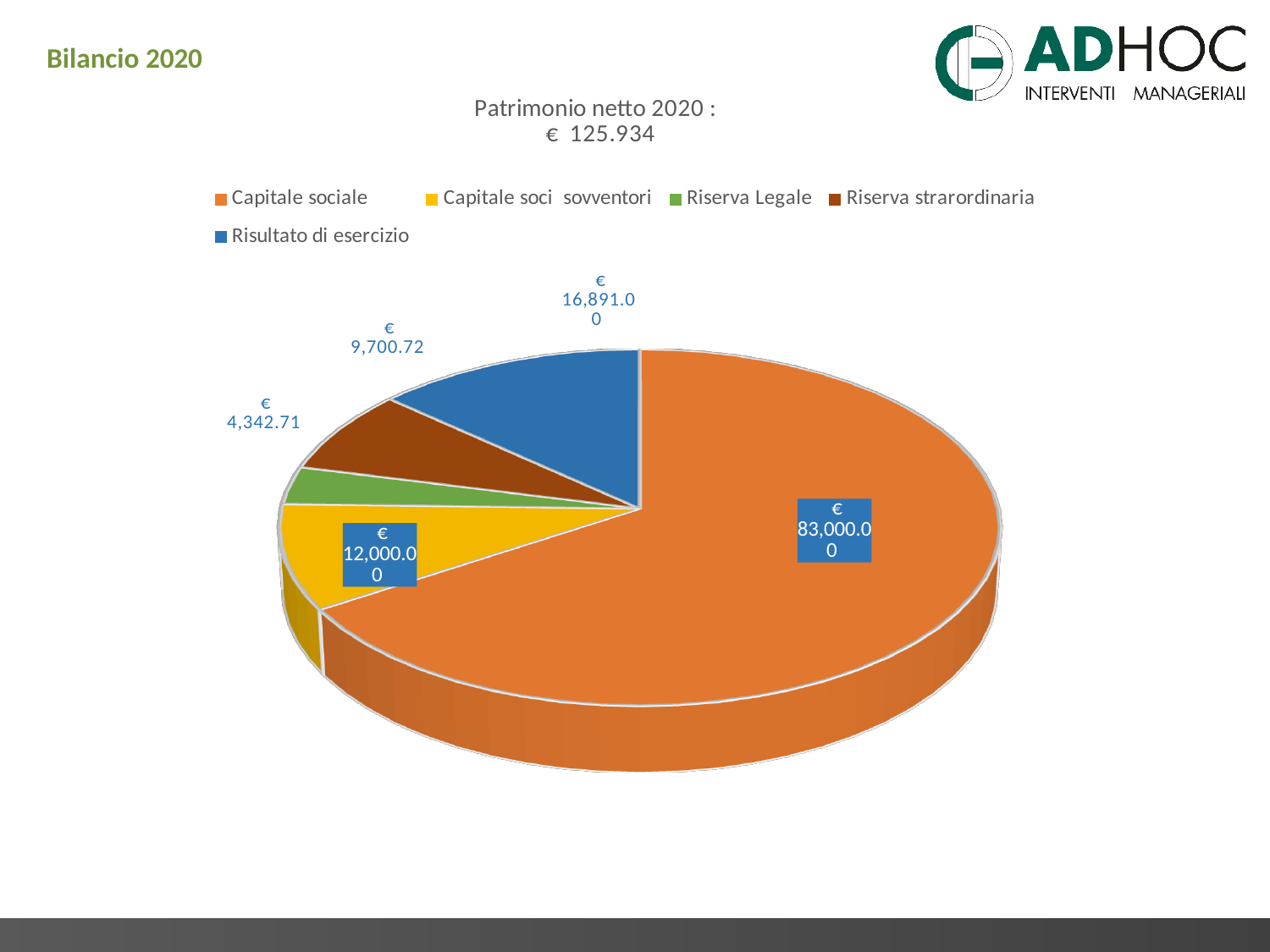
Which is larger, Risultato di esercizio or Riserva straordinaria? Risultato di esercizio Which category has the smallest slice of the pie? Riserva Legale Which category has the largest slice of the pie? Capitale sociale What is the value of the Capitale sociale slice? € 83,000.00 What is the difference between the Capitale sociale and Capitale soci sovventori values? € 71,000.00 What is the value of the Riserva Legale slice? € 4,342.71 What is the value of the Capitale soci sovventori slice? € 12,000.00 What is the value of the Riserva straordinaria slice? € 9,700.72 How many categories does the legend list? 5 What total is stated in the chart title for Patrimonio netto 2020? € 125.934 What is the value of the Risultato di esercizio slice? € 16,891.00 What kind of chart is shown on the slide? pie chart